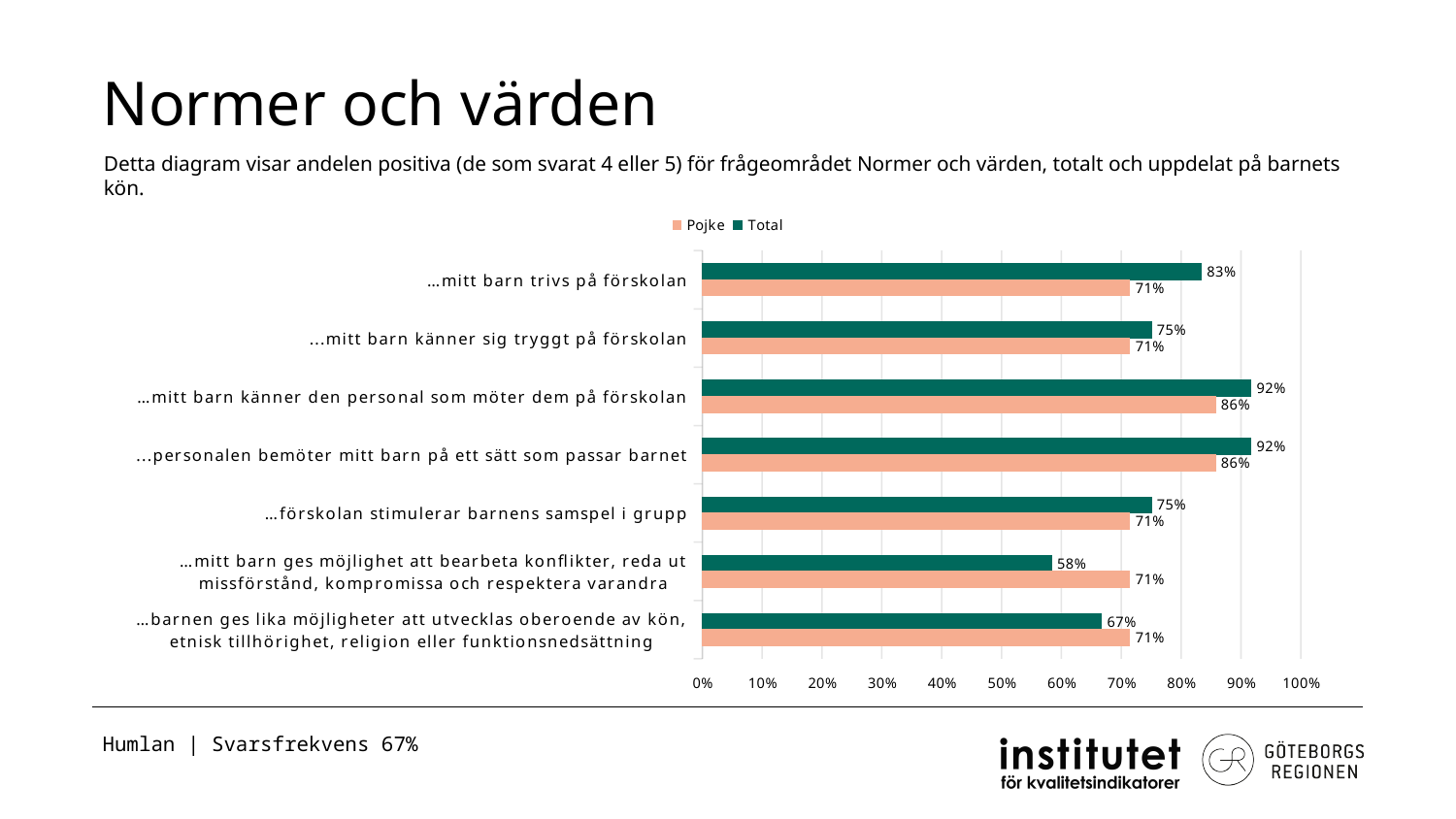
What is the Pojke value for "…förskolan stimulerar barnens samspel i grupp"? 71% What is the Total value for "…mitt barn trivs på förskolan"? 83% How many categories are shown in the chart? 7 What is the difference between the Pojke and Total values for "…barnen ges lika möjligheter att utvecklas oberoende av kön, etnisk tillhörighet, religion eller funktionsnedsättning"? 4 percentage points What is the difference between the Total and Pojke values for "…mitt barn trivs på förskolan"? 12 percentage points For "…mitt barn ges möjlighet att bearbeta konflikter, reda ut missförstånd, kompromissa och respektera varandra", which is larger, the Pojke value or the Total value? Pojke How many series does the legend list? 2 What kind of chart is shown on the slide? Bar chart What is the Total value for "…mitt barn ges möjlighet att bearbeta konflikter, reda ut missförstånd, kompromissa och respektera varandra"? 58% Is the Total value for "...personalen bemöter mitt barn på ett sätt som passar barnet" greater or less than 90%? greater Which category has the lowest Total value? …mitt barn ges möjlighet att bearbeta konflikter, reda ut missförstånd, kompromissa och respektera varandra What is the Pojke value for "…mitt barn känner den personal som möter dem på förskolan"? 86%